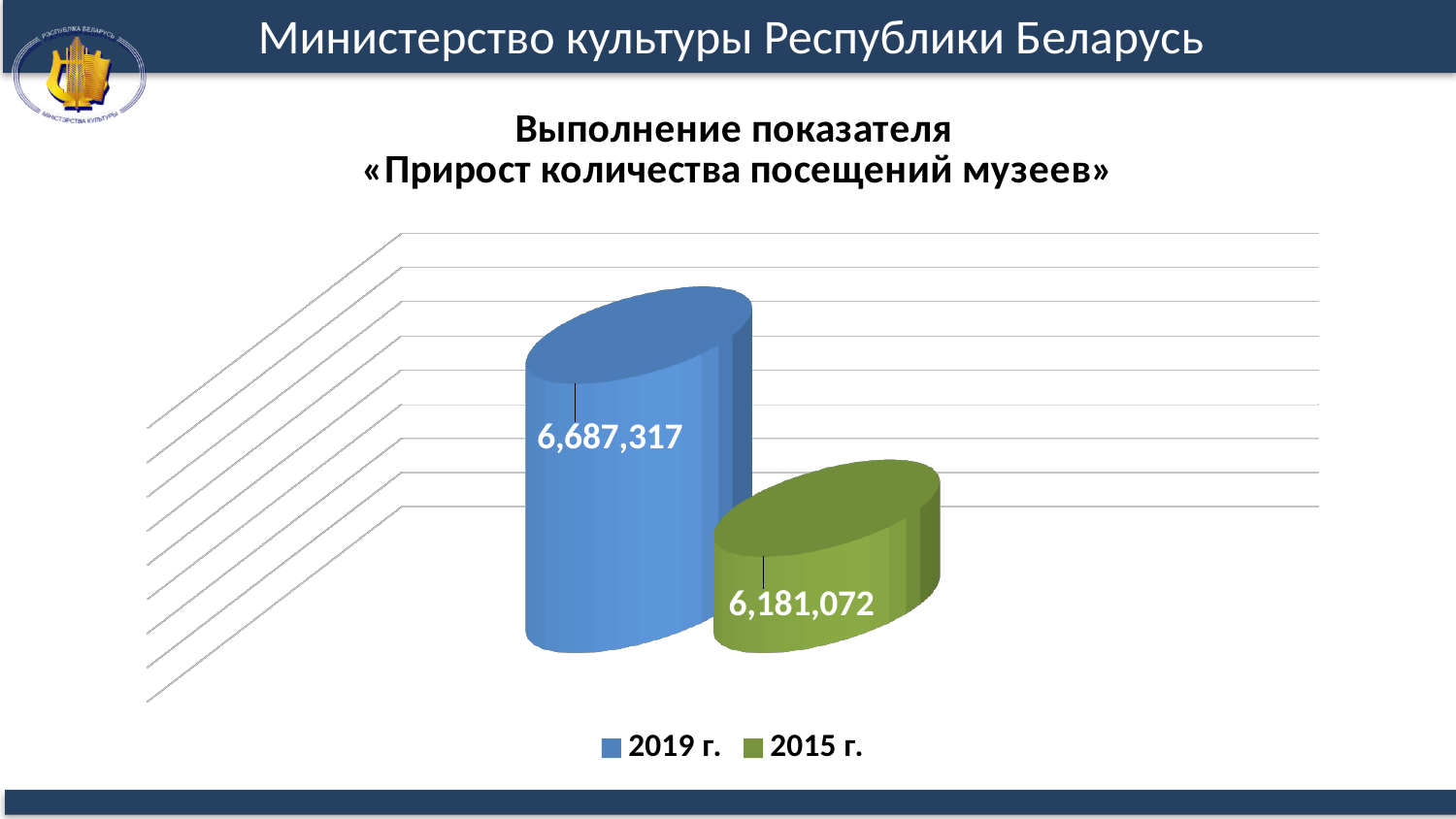
Which year has the lower value on the chart? 2015 г. How many series does the legend list? 2 How many bars are plotted on the chart? 2 What is the title of the chart? Выполнение показателя «Прирост количества посещений музеев» Which year has the higher value, 2019 г. or 2015 г.? 2019 г. What is the value shown for 2019 г.? 6,687,317 What kind of chart is shown on the slide? bar chart Is the value for 2015 г. larger or smaller than the value for 2019 г.? smaller Which colour represents 2015 г. in the legend? green What is the value shown for 2015 г.? 6,181,072 What is the difference between the 2019 г. value and the 2015 г. value? 506,245